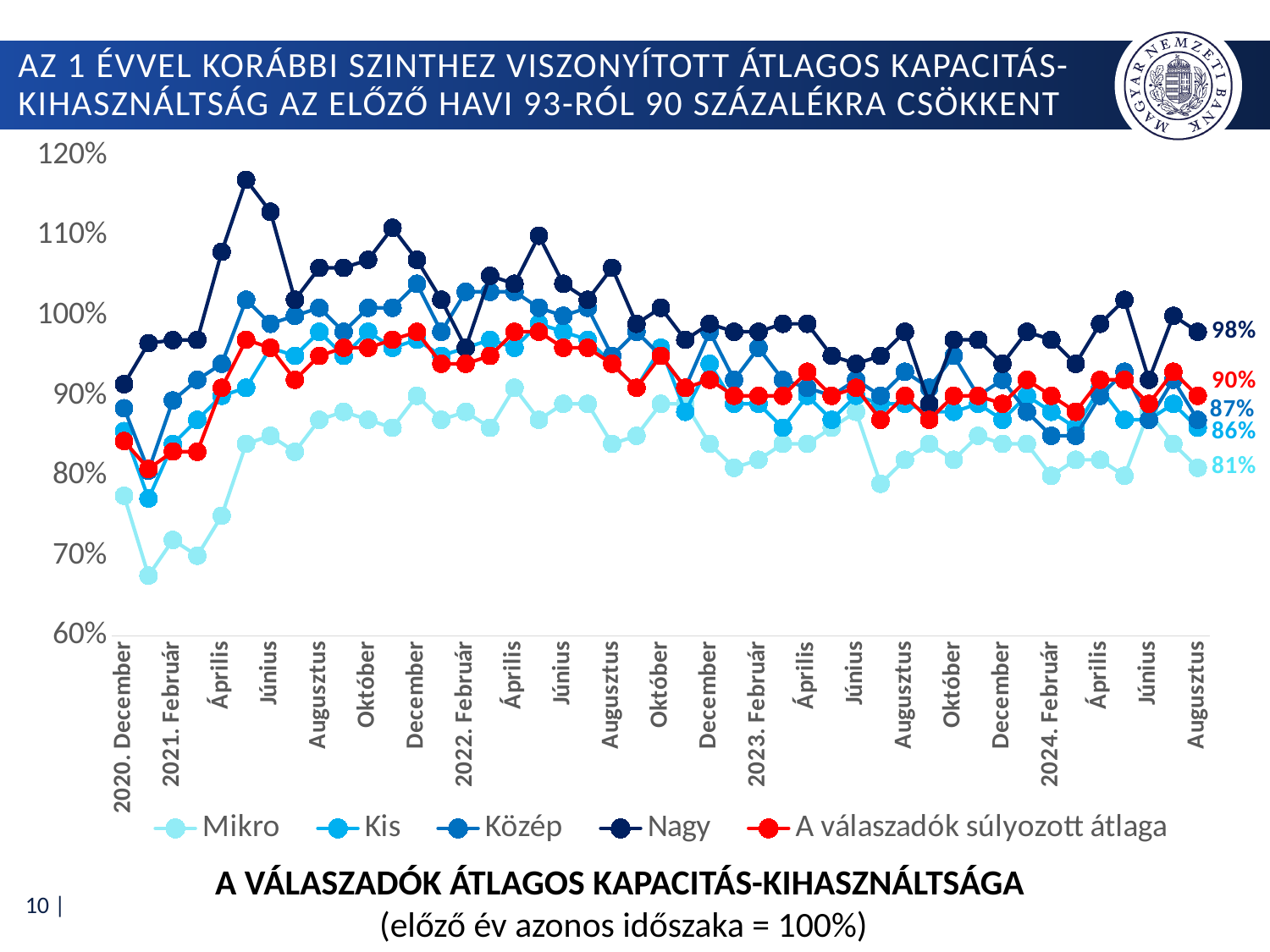
At 2024 Augusztus, which is larger: the Nagy value or the weighted average ('A válaszadók súlyozott átlaga') value? Nagy Is the lowest value of the Mikro series (early 2021) greater or less than 70%? less What is the value of the Nagy series at the last point (2024 Augusztus)? 98% Is the peak value of the Nagy series in 2021 greater or less than 110%? greater What is the difference between the Nagy and Mikro values at 2024 Augusztus? 17 percentage points What is the title shown below the chart? A válaszadók átlagos kapacitás-kihasználtsága (előző év azonos időszaka = 100%) Which series has the lowest value at 2024 Augusztus? Mikro Which series has the highest value at 2024 Augusztus? Nagy What is the value of the Mikro series at the last point (2024 Augusztus)? 81% How many series does the legend list? 5 What type of chart is shown on the slide? line chart What is the value of 'A válaszadók súlyozott átlaga' at the last point (2024 Augusztus)? 90%